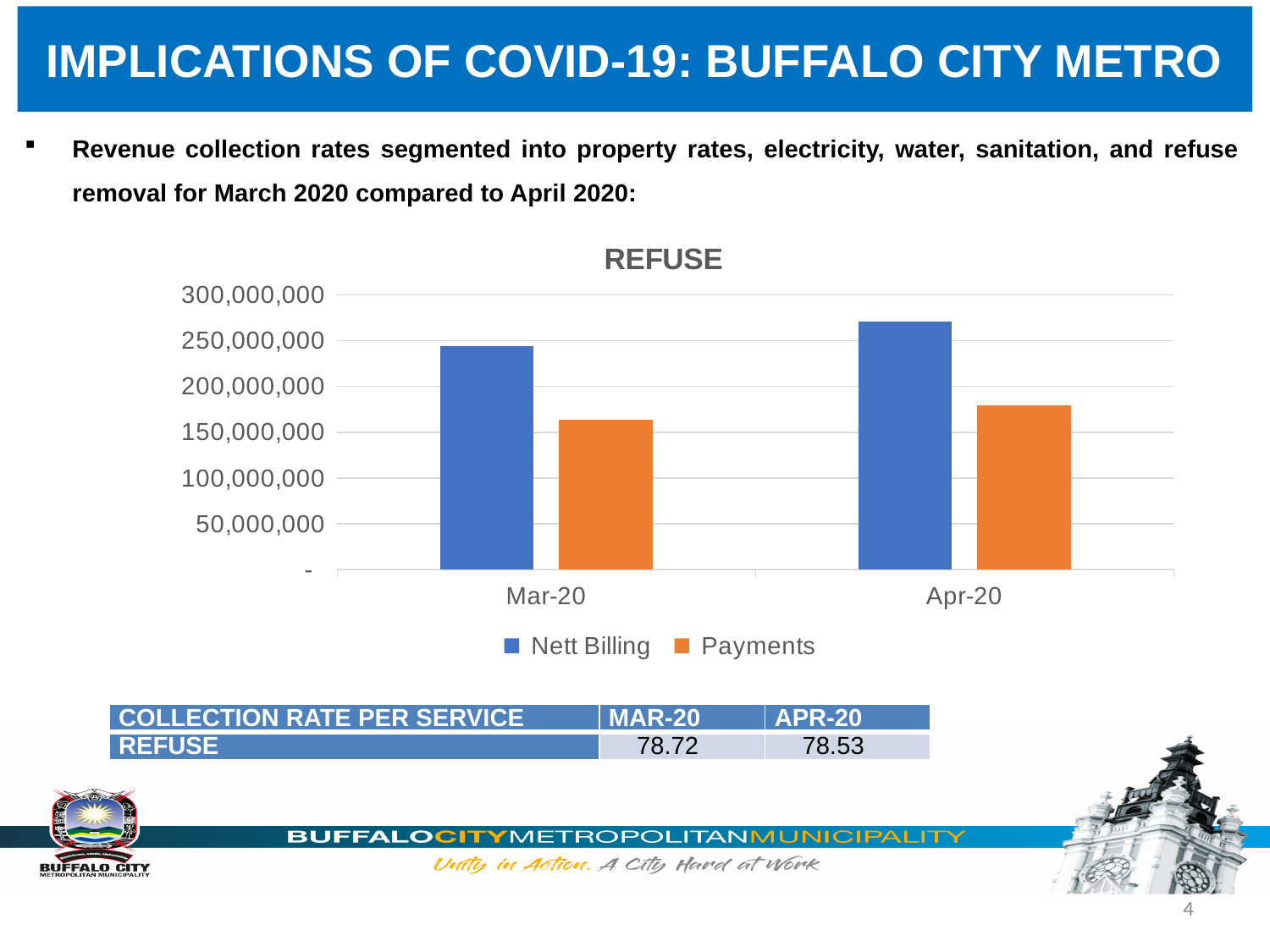
Is the Nett Billing value for Apr-20 greater or less than 250,000,000? greater What kind of chart is shown on the slide? bar chart In which month is Nett Billing highest? Apr-20 Does Nett Billing rise or fall from Mar-20 to Apr-20? rise Which two series are listed in the chart's legend? Nett Billing and Payments Is the Payments value for Apr-20 greater or less than 200,000,000? less What is the title of the chart? REFUSE Is the Nett Billing value for Mar-20 greater or less than 200,000,000? greater How many categories are shown on the x axis of the chart? 2 How many series does the chart's legend list? 2 For Mar-20, which is larger: Nett Billing or Payments? Nett Billing